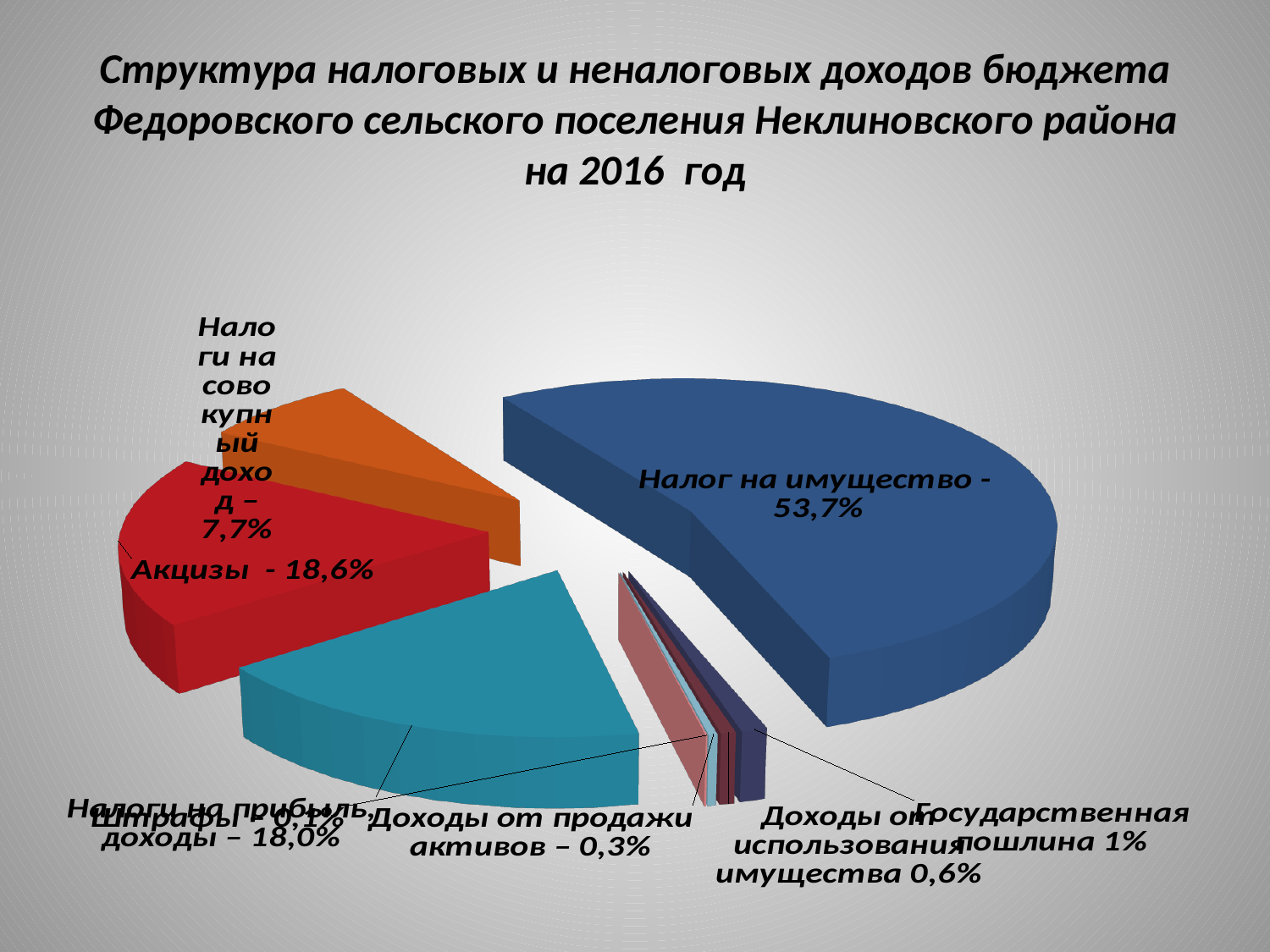
What share of the budget revenue is Акцизы? 18,6% What share of the budget revenue is Налог на имущество? 53,7% Which category has the smallest share of the pie? Штрафы What share of the budget revenue is Доходы от продажи активов? 0,3% What share of the budget revenue is Государственная пошлина? 1% What share of the budget revenue is Доходы от использования имущества? 0,6% Which is larger, the share for Акцизы or the share for Налоги на совокупный доход? Акцизы For which year does the chart show the budget revenue structure? 2016 What share of the budget revenue is Налоги на совокупный доход? 7,7% What is the difference between the share for Налог на имущество and the share for Акцизы? 35,1% What kind of chart is shown on the slide? pie chart Which category has the largest share of the pie? Налог на имущество